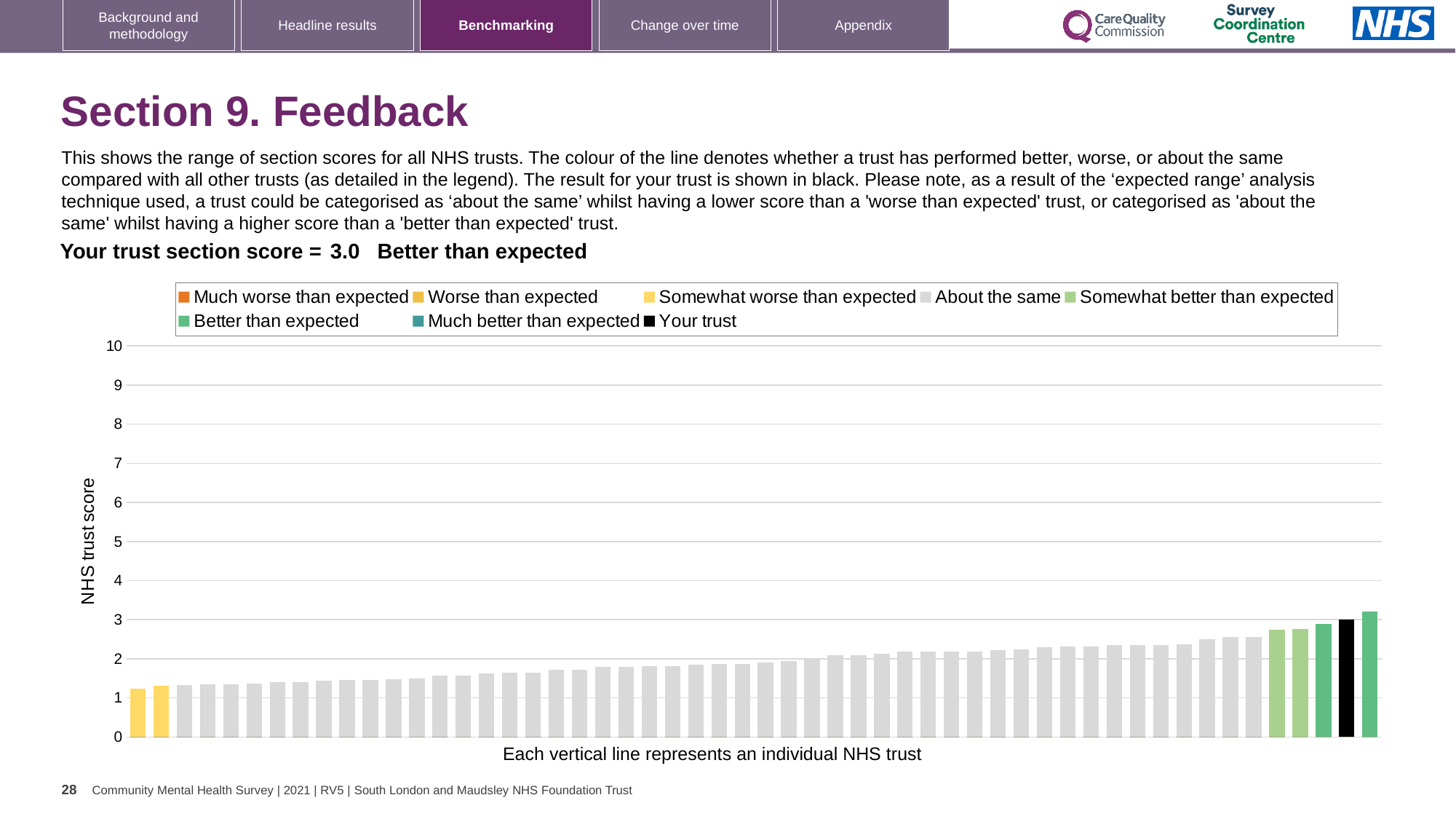
Do the bar values rise or fall from left to right along the x axis? rise How many bars are coloured yellow (somewhat worse than expected)? 2 What is the section score for your trust shown on the slide? 3.0 How many entries does the chart legend list? 8 Is the value of the lowest (leftmost) bar greater or less than 2? less Which performance category is your trust placed in according to the slide? Better than expected Is the value for your trust greater or less than 5? less What kind of chart is shown on the slide? bar chart What colour is the bar representing your trust? black What is the label on the vertical axis of the chart? NHS trust score Is the value of the highest (rightmost) bar greater or less than 4? less